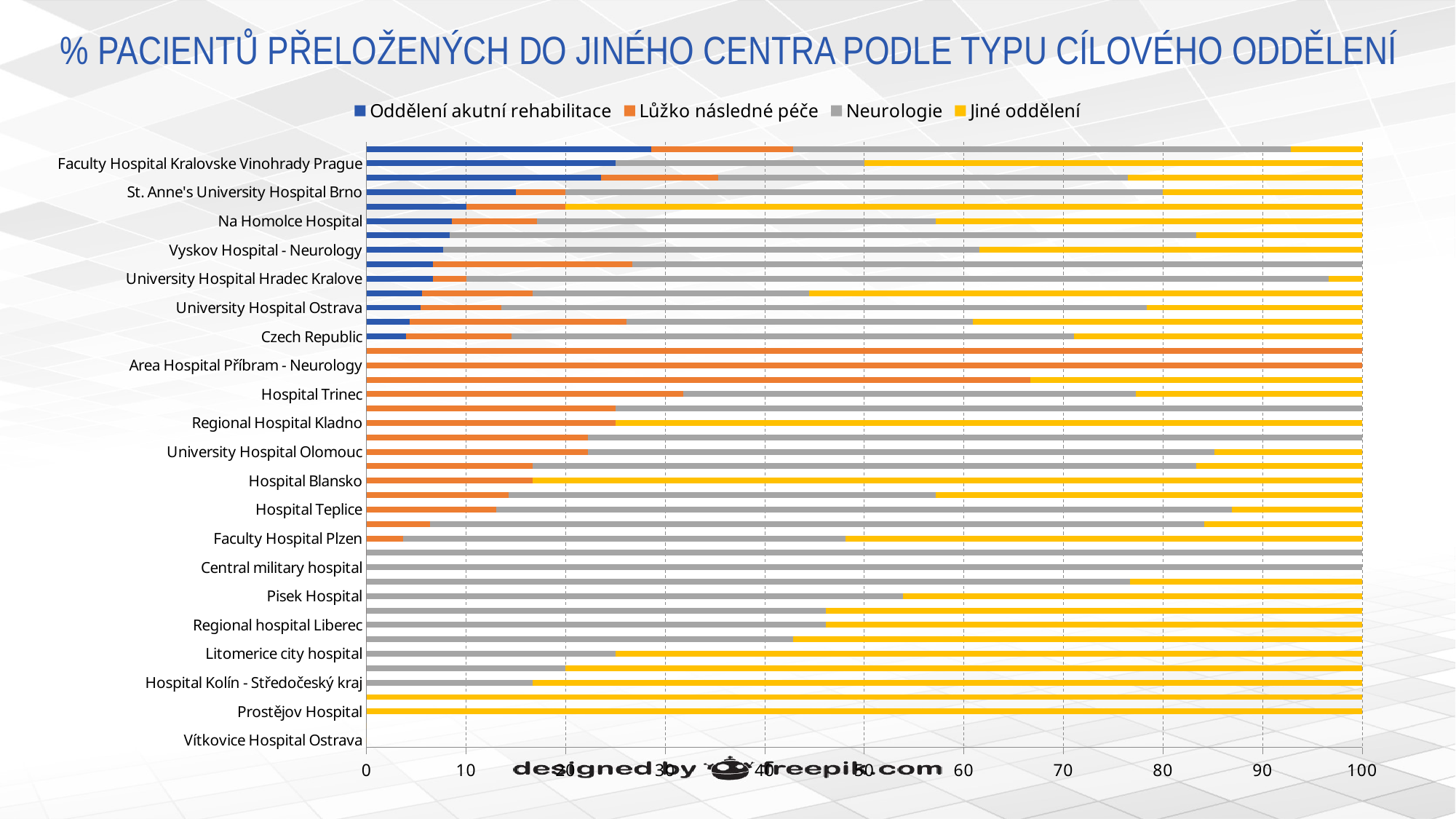
What kind of chart is shown on the slide? Stacked bar chart Is the Neurologie value for Central military hospital greater or less than 90? greater Which series is shown in blue in the legend? Oddělení akutní rehabilitace Is the Neurologie value for Hospital Kolín - Středočeský kraj greater or less than 20? less Is the Lůžko následné péče value for Regional Hospital Kladno greater or less than 30? less How many series does the legend list? 4 What is the title of the chart? % PACIENTŮ PŘELOŽENÝCH DO JINÉHO CENTRA PODLE TYPU CÍLOVÉHO ODDĚLENÍ